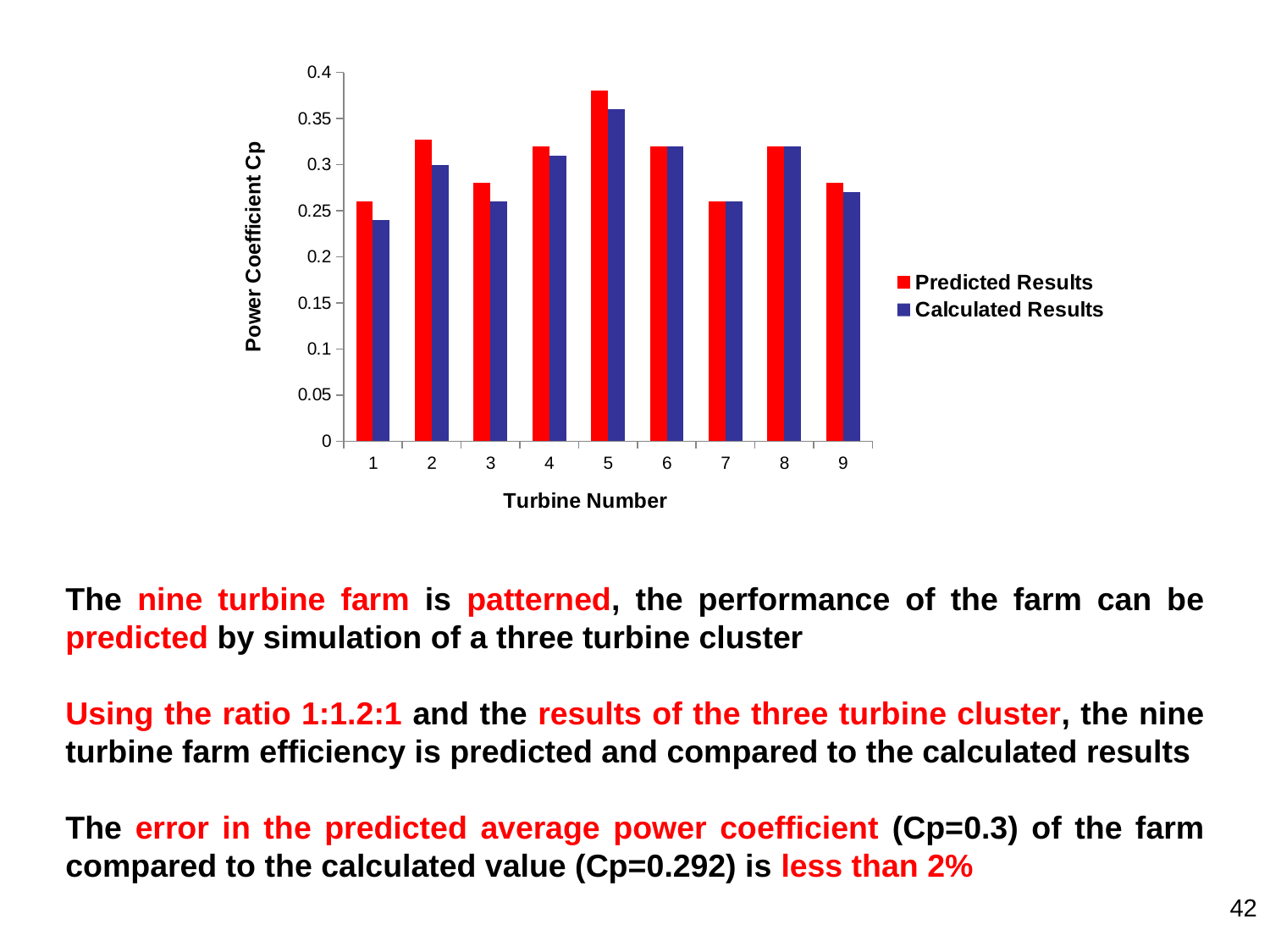
How many series does the legend list? 2 What is the title of the y axis? Power Coefficient Cp Is the Predicted Results value for turbine 7 greater or less than 0.3? less Is the Calculated Results value for turbine 1 greater or less than 0.25? less Is the Predicted Results value for turbine 2 greater or less than 0.3? greater Which turbine number has the highest Predicted Results value? 5 Which turbine number has the highest Calculated Results value? 5 For turbine 1, which is larger: the Predicted Results value or the Calculated Results value? Predicted Results Which turbine number has the lowest Calculated Results value? 1 How many turbine numbers are shown on the x axis? 9 What kind of chart is shown on the slide? bar chart